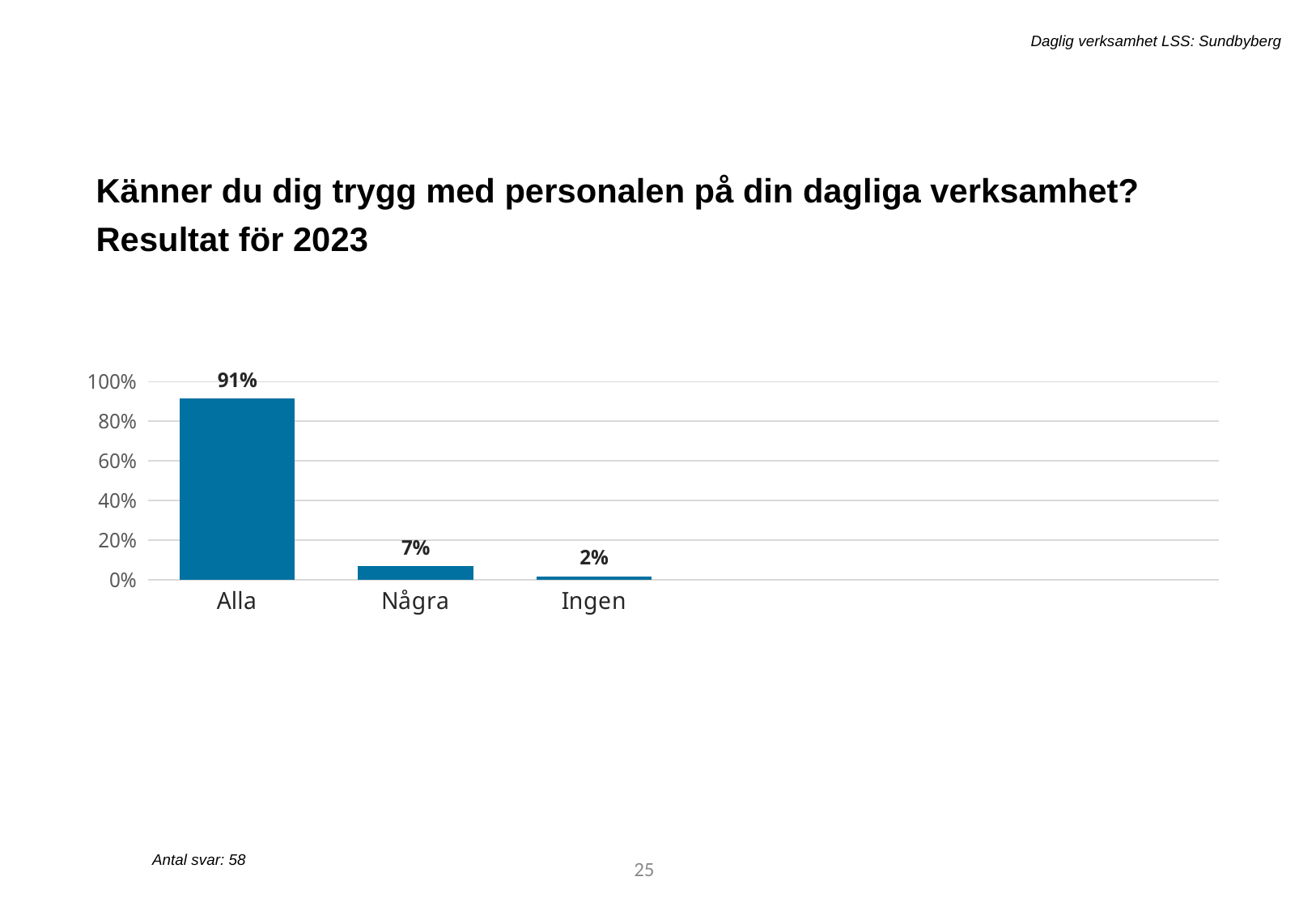
What is the difference between the values for Alla and Några? 84% How many categories are shown on the x axis? 3 Is the value for Alla greater or less than 80%? greater What is the value for Ingen? 2% Which is larger, the value for Några or the value for Ingen? Några What is the difference between the values for Några and Ingen? 5% Which category has the lowest value? Ingen What kind of chart is shown on the slide? bar chart What is the value for Några? 7% What is the value for Alla? 91% Do the values rise or fall from left to right along the x axis? fall Which category has the highest value? Alla